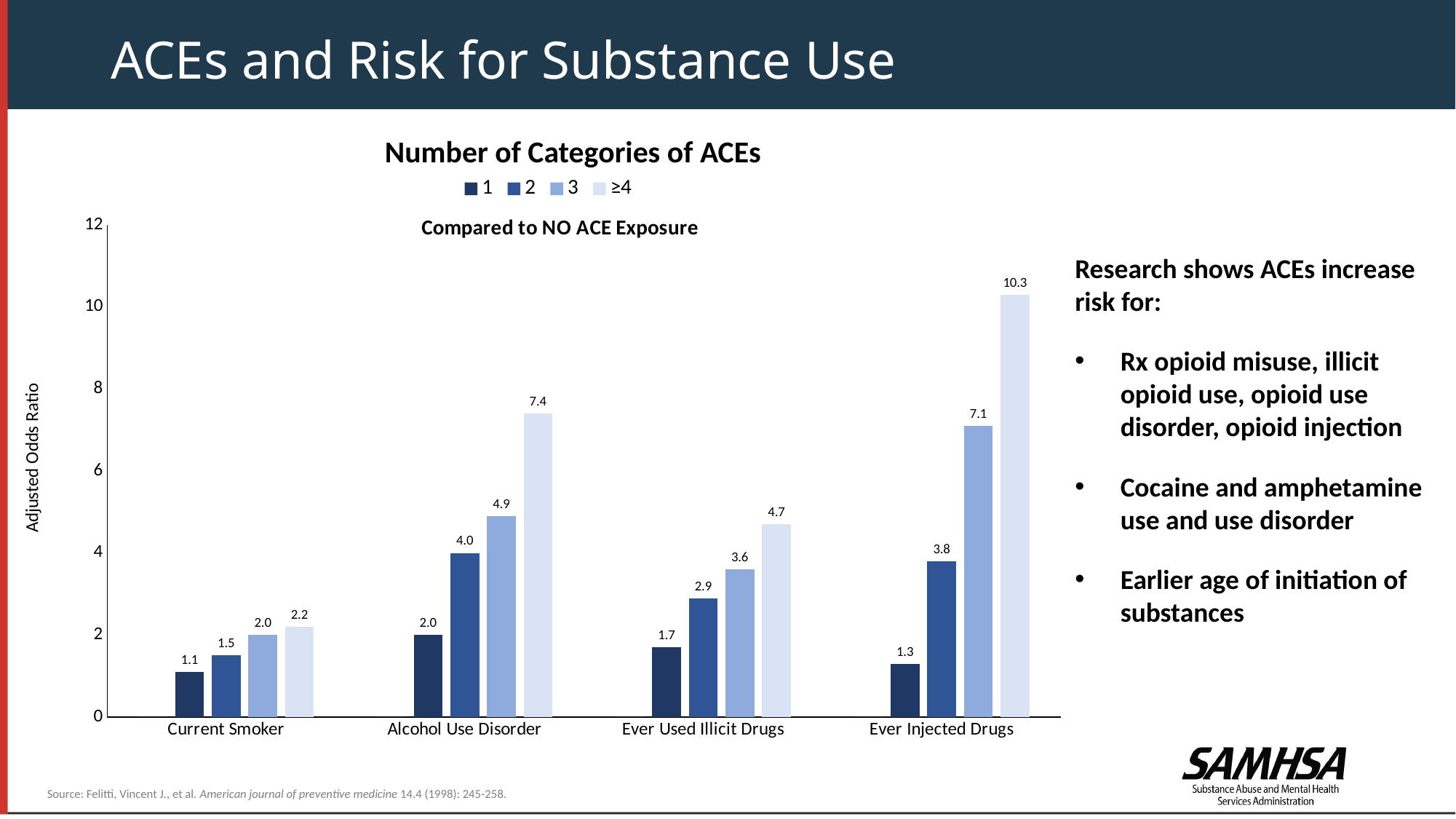
Which is larger: the 3 ACEs value for Alcohol Use Disorder or the ≥4 ACEs value for Ever Used Illicit Drugs? Alcohol Use Disorder (4.9) What is the difference between the ≥4 and 1 ACEs values for Ever Injected Drugs? 9.0 Is the ≥4 ACEs value for Alcohol Use Disorder greater or less than 8? less What is the adjusted odds ratio for Alcohol Use Disorder with 2 categories of ACEs? 4.0 What is the adjusted odds ratio for Current Smoker with 1 category of ACEs? 1.1 Which category has the highest adjusted odds ratio for the ≥4 ACEs series? Ever Injected Drugs Which category has the lowest adjusted odds ratio for the 3 ACEs series? Current Smoker What is the label of the y axis? Adjusted Odds Ratio How many series does the legend list? 4 How many categories are shown on the x axis? 4 What is the adjusted odds ratio for Ever Injected Drugs with ≥4 categories of ACEs? 10.3 What kind of chart is shown on the slide? Bar chart